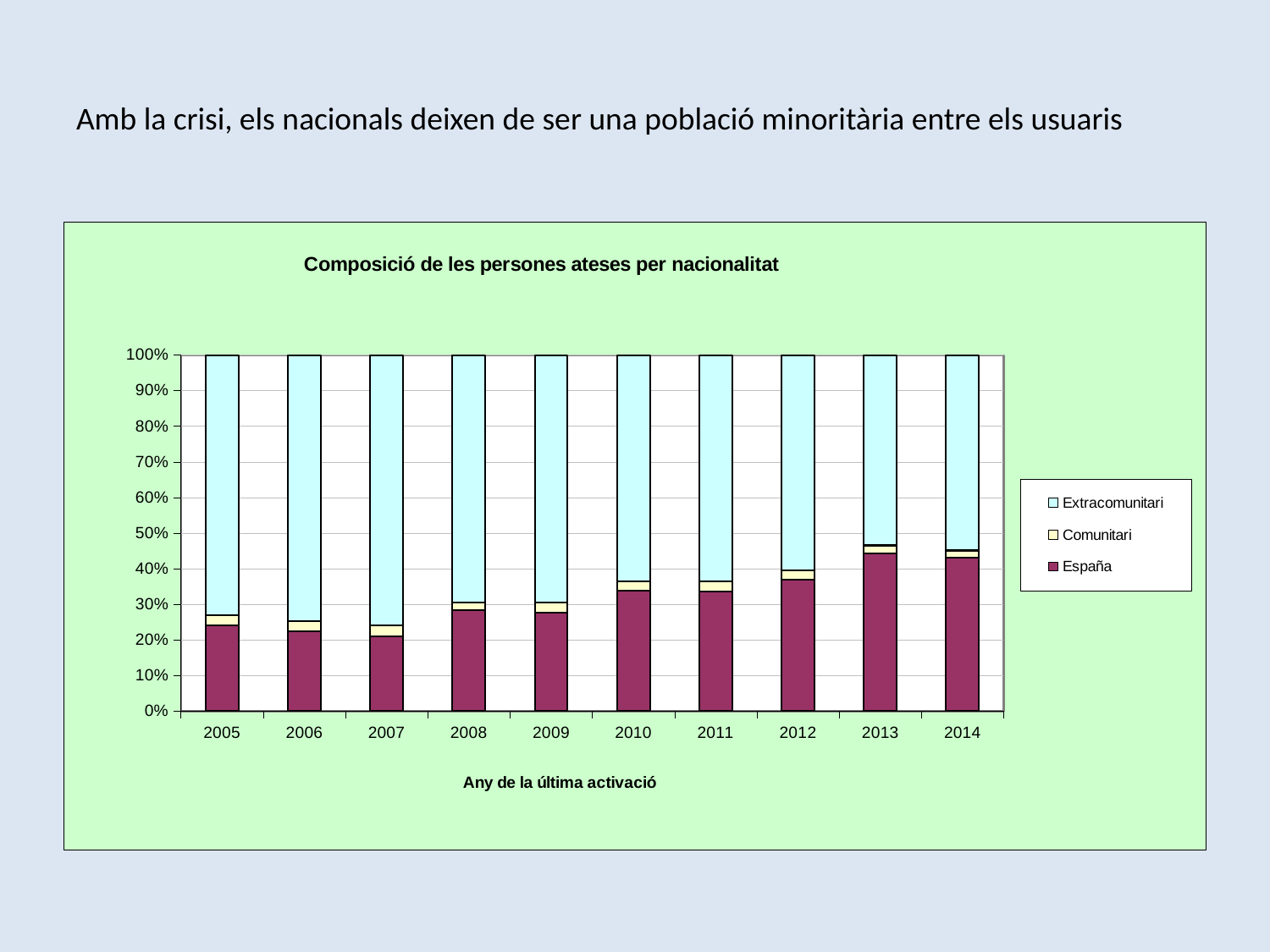
How many years are shown on the x axis? 10 Is the share of Extracomunitari in 2005 greater or less than 70%? greater What kind of chart is shown on the slide? Stacked bar chart What is the title of the chart? Composició de les persones ateses per nacionalitat What is the label of the x axis? Any de la última activació Does the España share generally rise or fall from 2005 to 2014? rise Is the share of Extracomunitari in 2014 greater or less than 60%? less How many series does the legend list? 3 Is the share of Comunitari in 2005 greater or less than 10%? less Which is larger, the España share in 2005 or in 2013? 2013